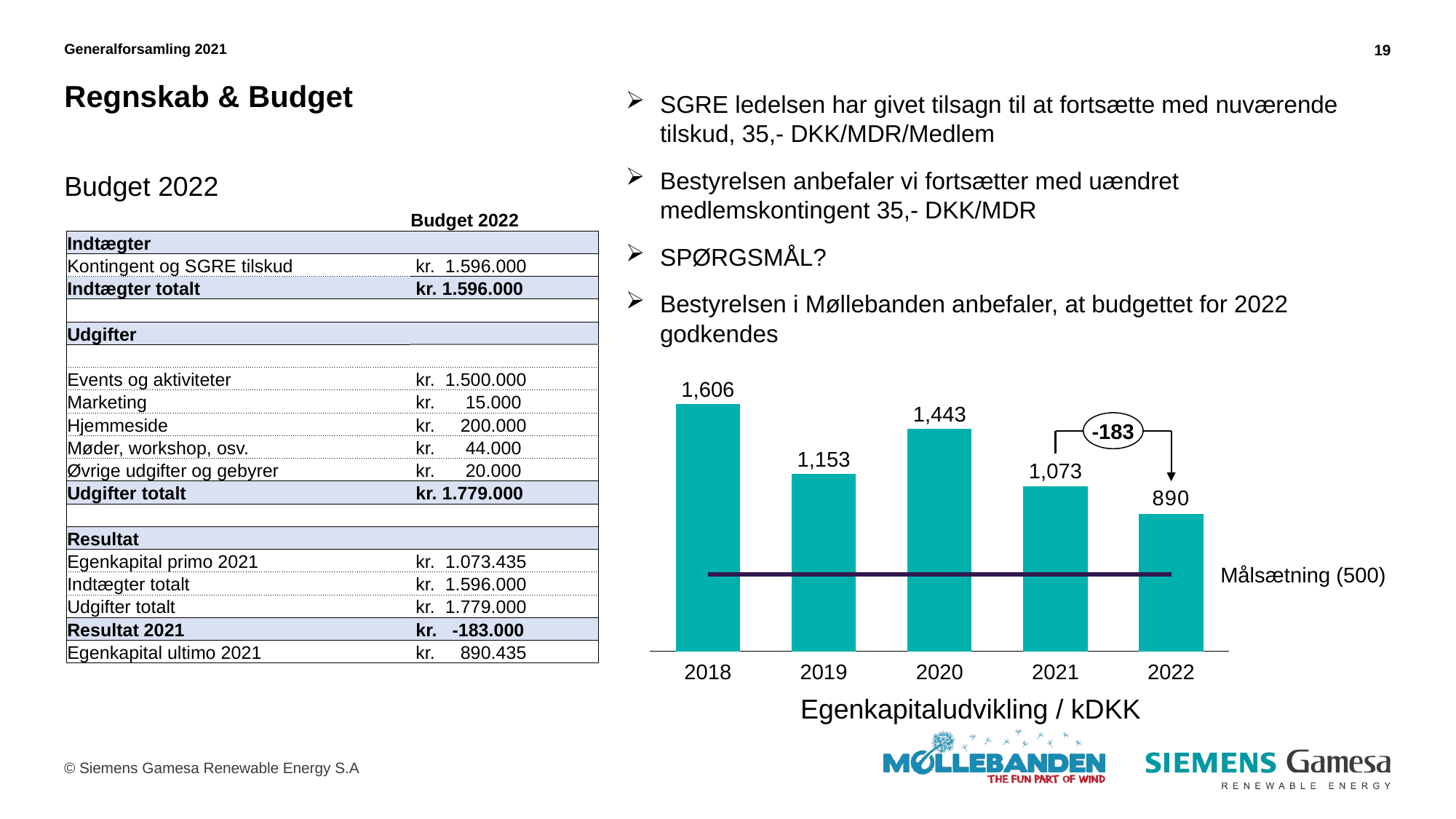
What is the value for 2022 in the Egenkapitaludvikling / kDKK chart? 890 In the Egenkapitaludvikling / kDKK chart, does the value rise or fall from 2020 to 2022? fall What is the difference between the 2018 and 2019 values in the Egenkapitaludvikling / kDKK chart? 453 How many years are shown in the Egenkapitaludvikling / kDKK chart? 5 What is the value for 2020 in the Egenkapitaludvikling / kDKK chart? 1,443 What target value does the horizontal line in the Egenkapitaludvikling / kDKK chart represent? Målsætning (500) In the Egenkapitaludvikling / kDKK chart, which is larger, the value for 2019 or the value for 2020? 2020 What is the difference between the 2021 and 2022 values in the Egenkapitaludvikling / kDKK chart? 183 Which year has the lowest value in the Egenkapitaludvikling / kDKK chart? 2022 What kind of chart is the Egenkapitaludvikling / kDKK chart? bar chart What is the value for 2018 in the Egenkapitaludvikling / kDKK chart? 1,606 Which year has the highest value in the Egenkapitaludvikling / kDKK chart? 2018